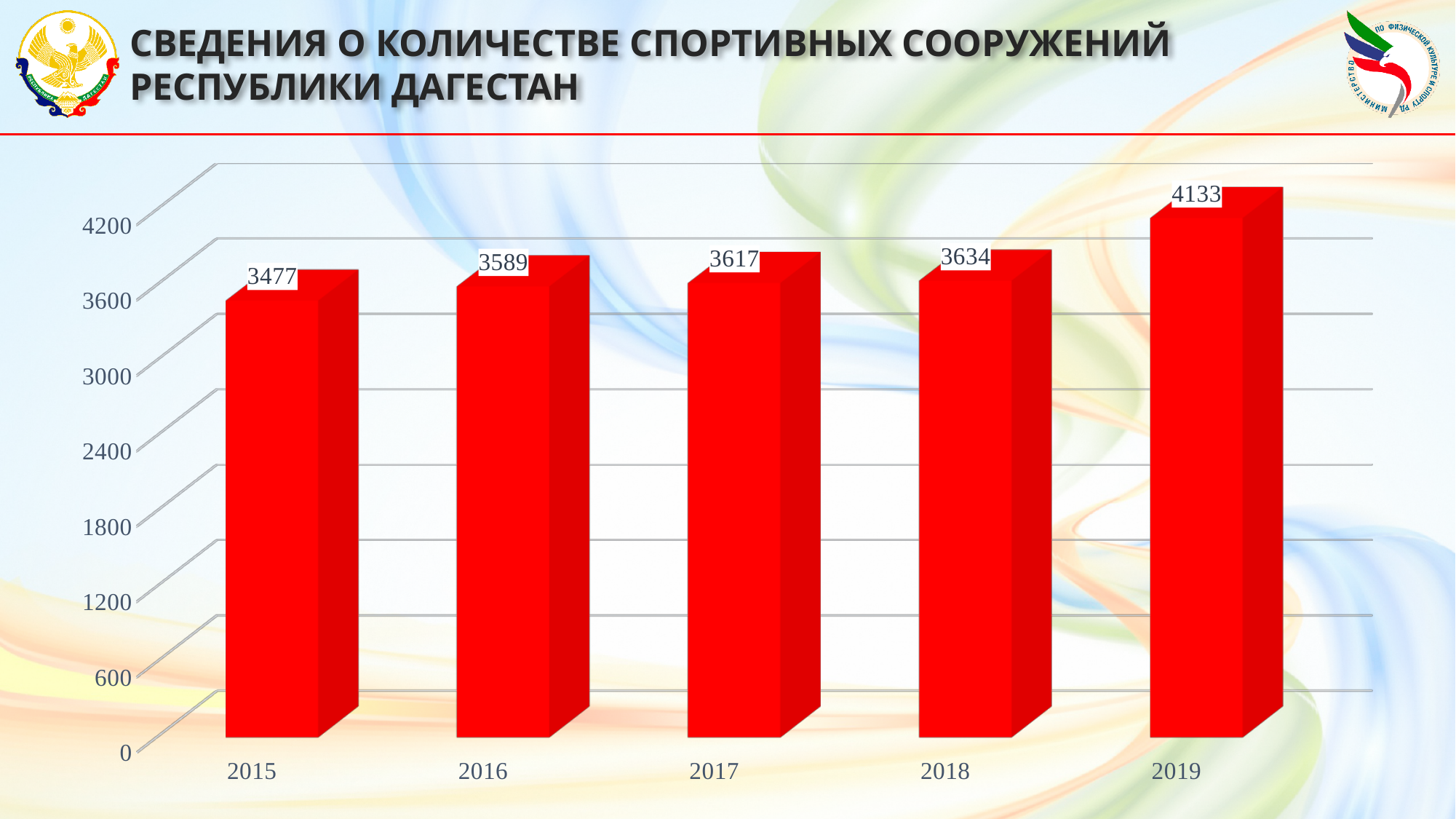
What is the value for 2017? 3617 Do the values rise or fall from 2015 to 2019? rise Is the value for 2019 greater or less than 4200? less How many years are shown on the chart? 5 Which year has the highest value? 2019 What is the value for 2019? 4133 What kind of chart is shown on the slide? bar chart Which year has the lowest value? 2015 What is the difference between the values for 2019 and 2018? 499 What is the value for 2015? 3477 What is the difference between the values for 2016 and 2015? 112 Which is larger, the value for 2016 or the value for 2018? 2018